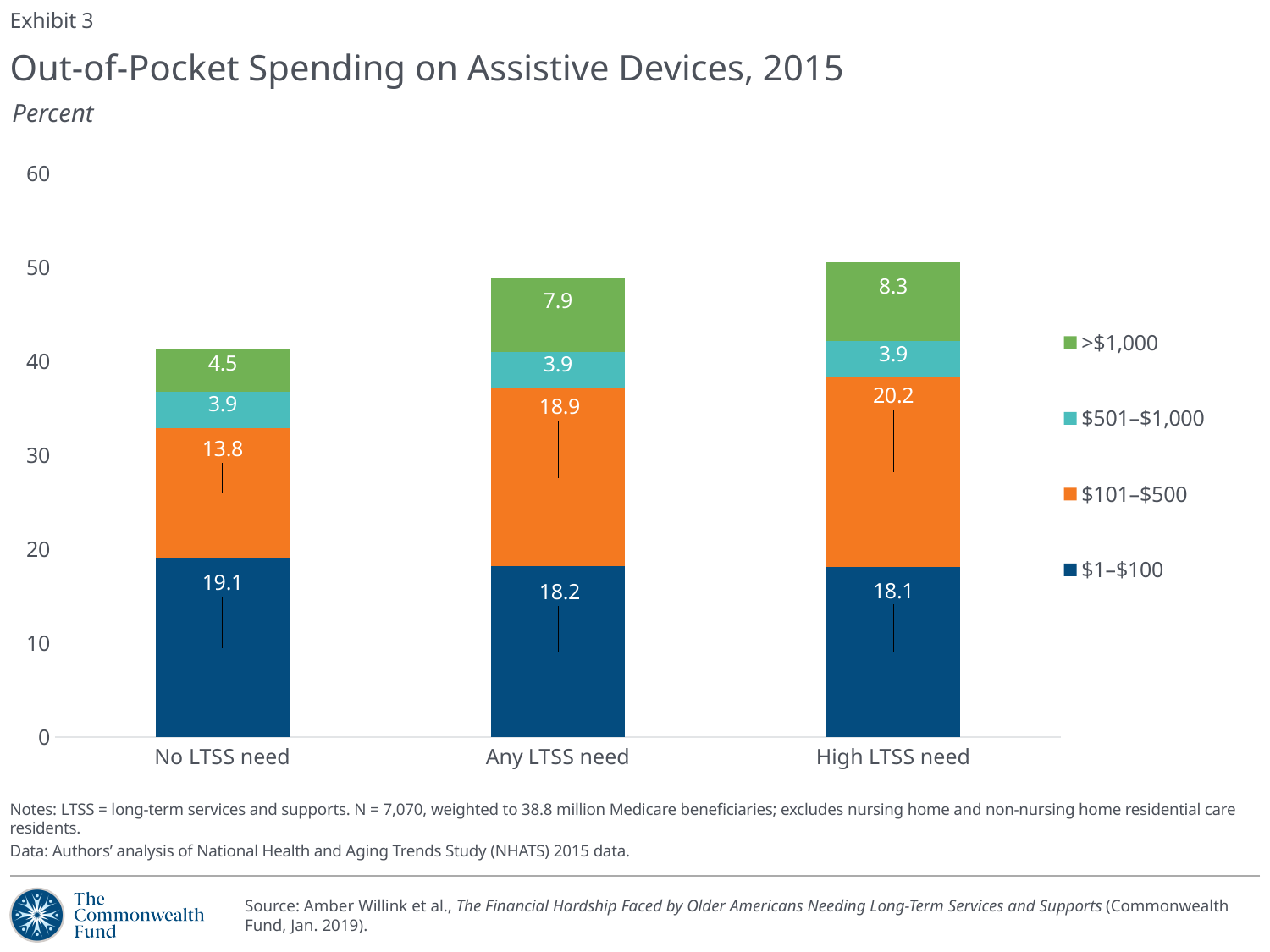
Which is larger: the $1–$100 value for No LTSS need or for Any LTSS need? No LTSS need What is the difference between the $101–$500 values for High LTSS need and No LTSS need? 6.4 What is the value for the $1–$100 segment in the No LTSS need bar? 19.1 What is the total of the stacked bar for No LTSS need? 41.3 How many categories are shown on the x axis? 3 What is the total of the stacked bar for Any LTSS need? 48.9 Which category has the lowest value for the $101–$500 segment? No LTSS need What kind of chart is shown on the slide? Stacked bar chart What is the value for the >$1,000 segment in the Any LTSS need bar? 7.9 Which category has the highest value for the >$1,000 segment? High LTSS need How many series does the legend list? 4 What is the value for the $101–$500 segment in the High LTSS need bar? 20.2